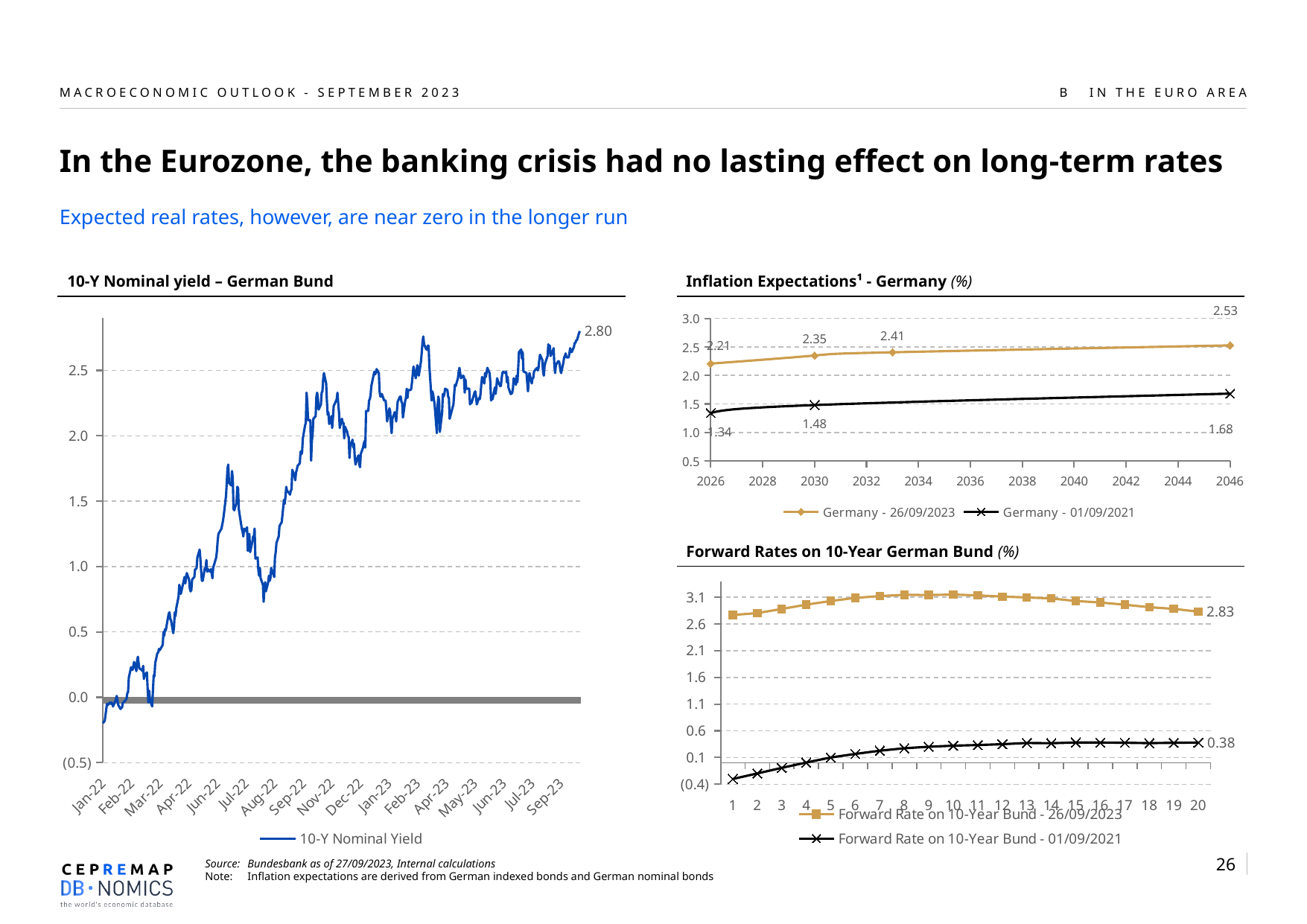
How many series does the legend of the 'Inflation Expectations - Germany' chart list? 2 In the 'Inflation Expectations - Germany' chart, what is the value for Germany - 01/09/2021 at 2030? 1.48 In the 'Inflation Expectations - Germany' chart, what is the difference between the 26/09/2023 and 01/09/2021 values at 2046? 0.85 In the '10-Y Nominal yield – German Bund' chart, is the value at Jan-22 greater or less than 0.5? less In the 'Forward Rates on 10-Year German Bund' chart, what is the value for the 26/09/2023 series at point 20? 2.83 How many points are shown on the x axis of the 'Forward Rates on 10-Year German Bund' chart? 20 What kind of chart is the '10-Y Nominal yield – German Bund' chart? line chart In the '10-Y Nominal yield – German Bund' chart, does the yield overall rise or fall from Jan-22 to Sep-23? rise In the 'Forward Rates on 10-Year German Bund' chart, what is the difference between the two series at point 20? 2.45 In the '10-Y Nominal yield – German Bund' chart, what is the latest value labelled at the end of the line? 2.80 In the 'Inflation Expectations - Germany' chart, which series is higher at 2030? Germany - 26/09/2023 In the 'Inflation Expectations - Germany' chart, what is the value for Germany - 26/09/2023 at 2046? 2.53